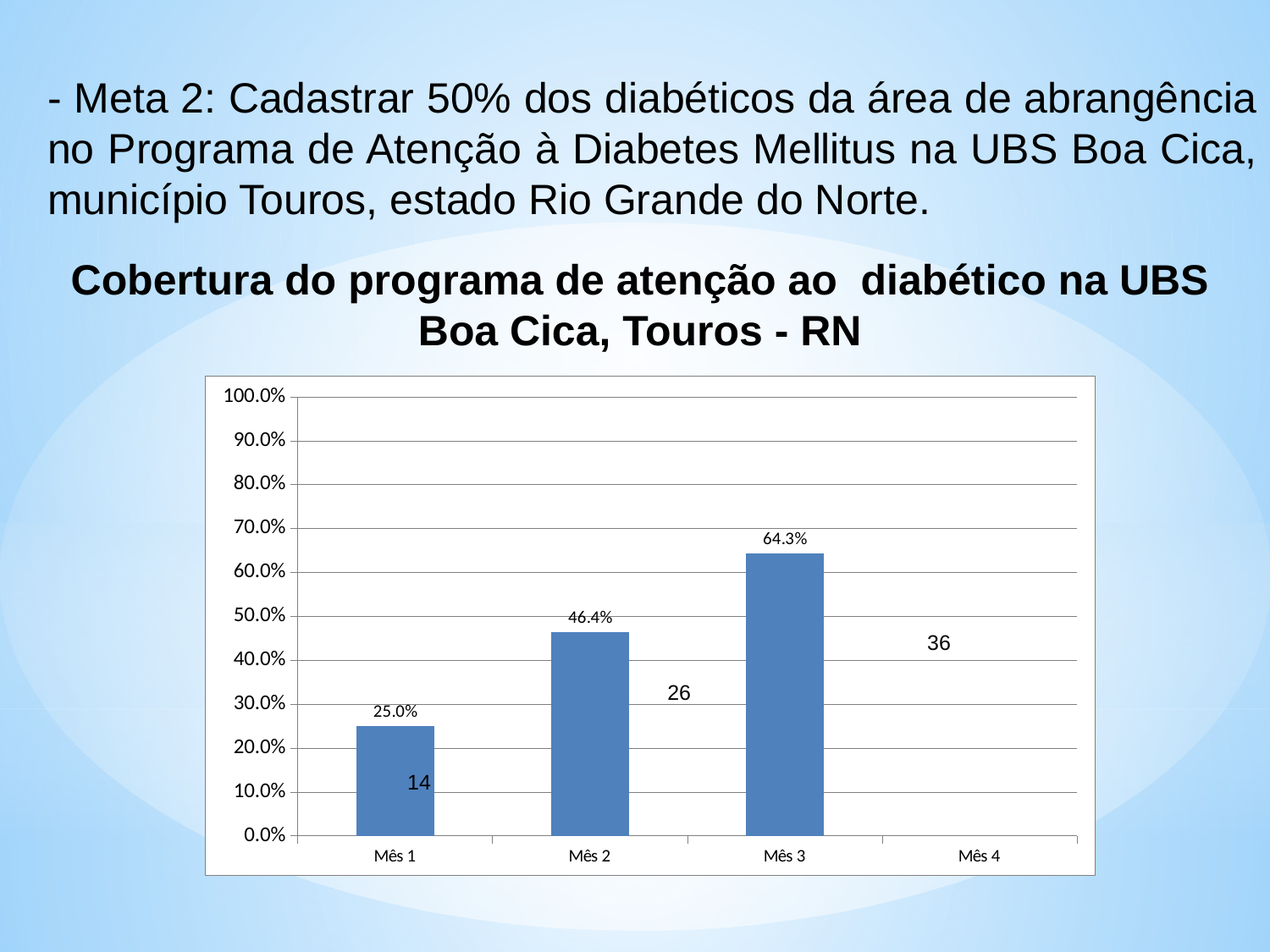
What is the value for Mês 3? 64.3% What is the value for Mês 2? 46.4% How many categories are shown on the x axis? 4 What kind of chart is shown? bar chart What is the value for Mês 1? 25.0% What is the difference between the values for Mês 3 and Mês 1? 39.3% Is the value for Mês 2 greater or less than 50.0%? less Do the values rise or fall from Mês 1 to Mês 3? rise What is the difference between the values for Mês 2 and Mês 1? 21.4% Which is larger, the value for Mês 2 or the value for Mês 3? Mês 3 Among the months with a bar, which has the lowest value? Mês 1 Which month has the highest value? Mês 3